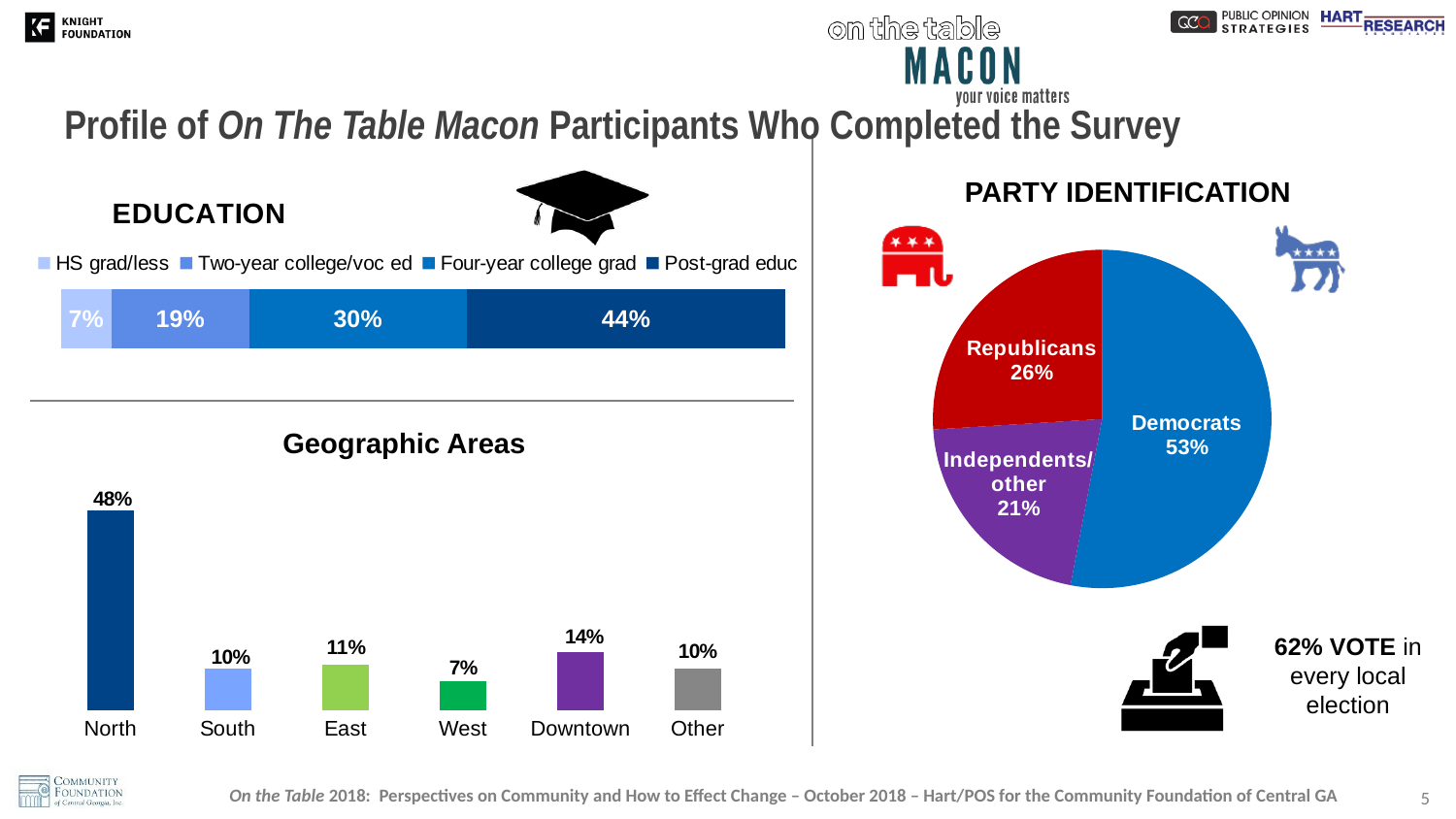
In the Geographic Areas chart, how many areas are shown? 6 How many series does the legend of the Education chart list? 4 In the Party Identification chart, what share are Democrats? 53% In the Education chart, what is the combined value of Four-year college grad and Post-grad educ? 74% In the Geographic Areas chart, what is the value for North? 48% In the Geographic Areas chart, which area has the lowest value? West In the Party Identification chart, which group has the smallest slice? Independents/other What kind of chart is the Geographic Areas chart? Bar chart In the Geographic Areas chart, what is the difference between Downtown and South? 4% In the Geographic Areas chart, which is larger, East or West? East In the Party Identification chart, what is the difference between Republicans and Independents/other? 5% In the Education chart, what is the value for Post-grad educ? 44%